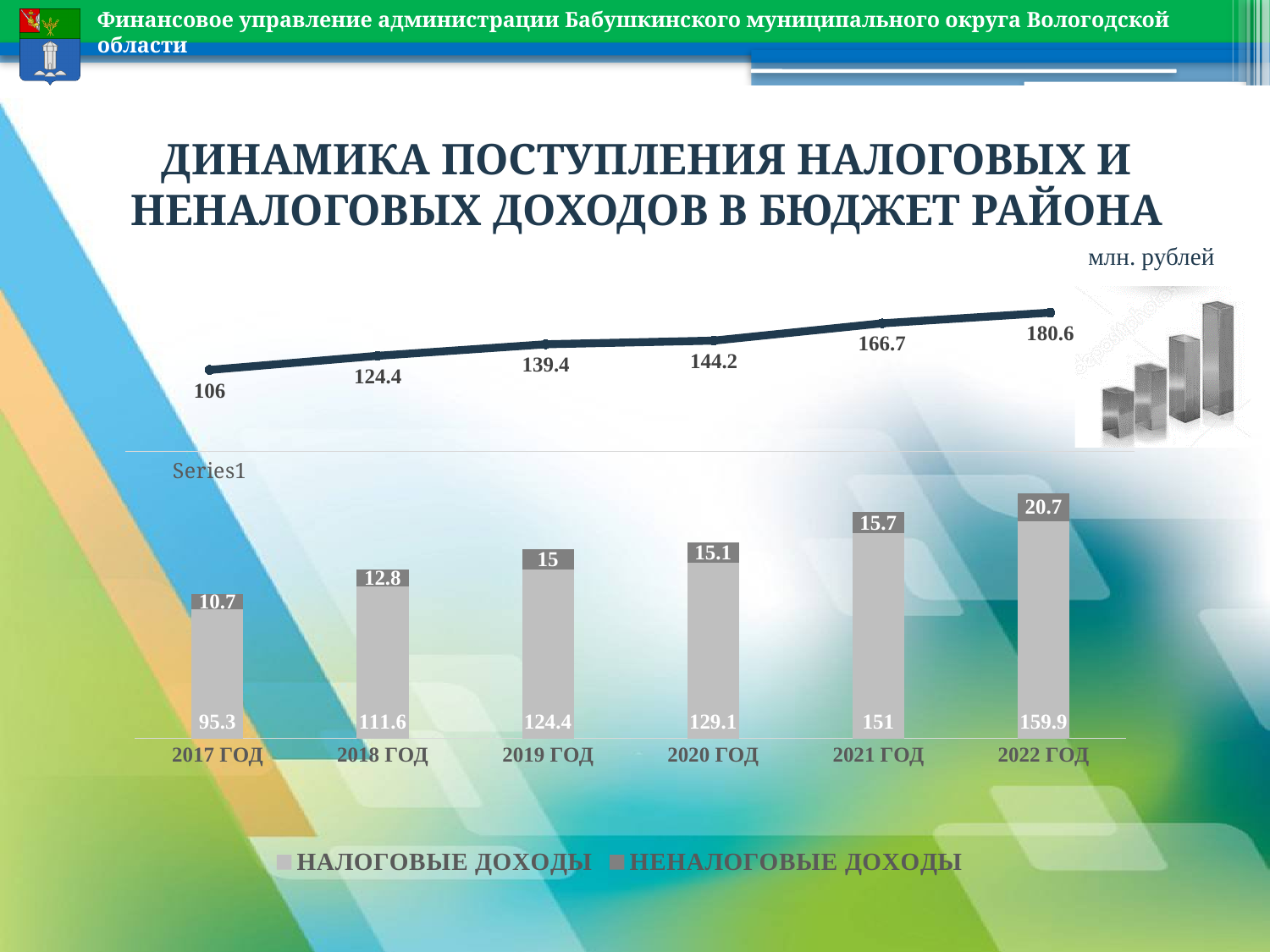
In the stacked bar chart, what is the total of the bar for 2019 ГОД? 139.4 What kind of chart is the lower chart on the slide? Stacked bar chart In the stacked bar chart, is НАЛОГОВЫЕ ДОХОДЫ larger in 2018 ГОД or in 2019 ГОД? 2019 ГОД In the stacked bar chart, what is the value of НЕНАЛОГОВЫЕ ДОХОДЫ for 2017 ГОД? 10.7 In the stacked bar chart, which year has the lowest value of НАЛОГОВЫЕ ДОХОДЫ? 2017 ГОД In the stacked bar chart, what is the value of НАЛОГОВЫЕ ДОХОДЫ for 2022 ГОД? 159.9 How many years are shown on the x axis of the stacked bar chart? 6 How many series does the legend of the stacked bar chart list? 2 In the line chart at the top, what is the value of the last (rightmost) point? 180.6 In the line chart at the top, do the values rise or fall from left to right? Rise In the stacked bar chart, which year has the highest value of НЕНАЛОГОВЫЕ ДОХОДЫ? 2022 ГОД In the stacked bar chart, what is the difference between НАЛОГОВЫЕ ДОХОДЫ in 2021 ГОД and 2020 ГОД? 21.9